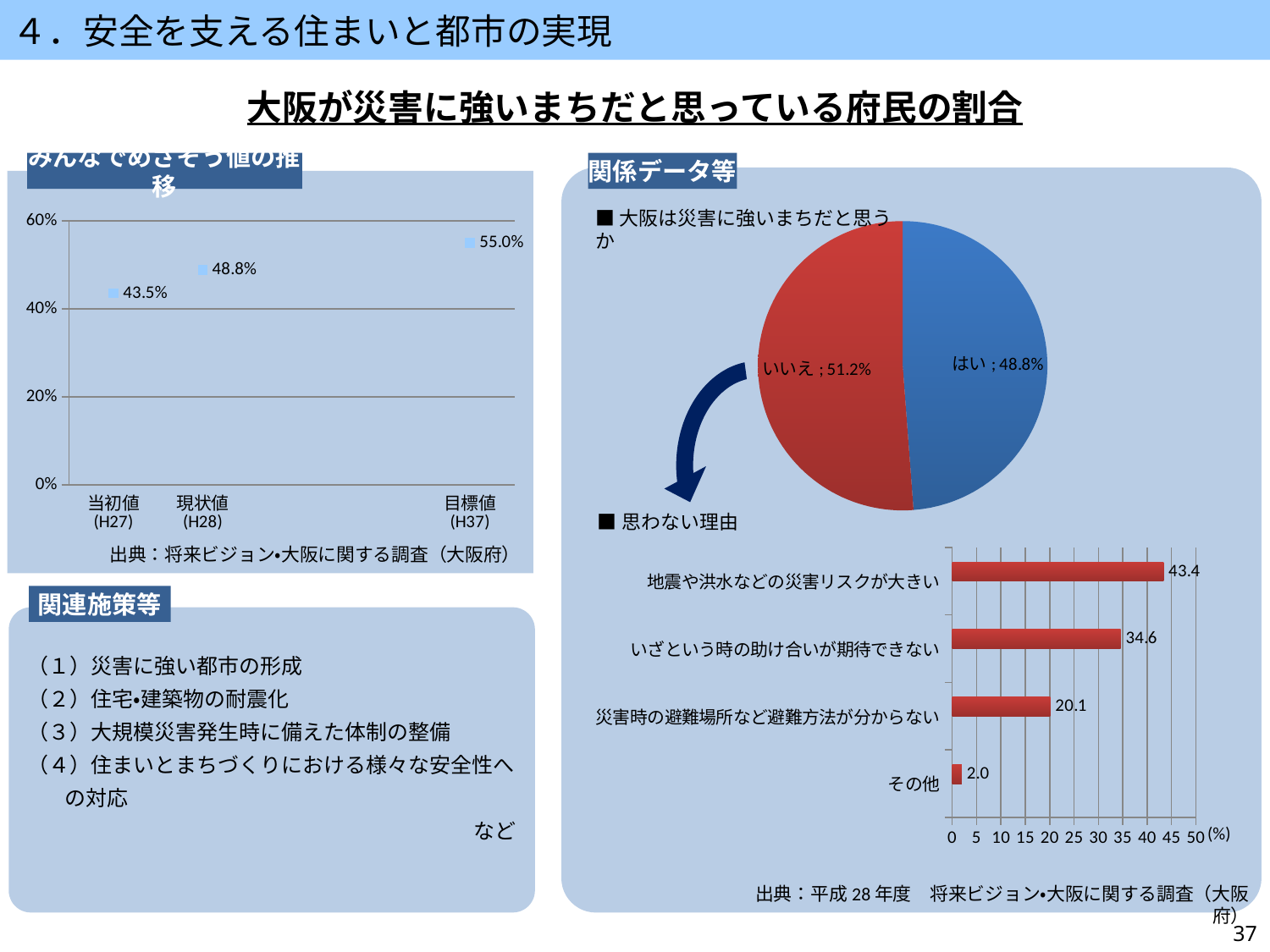
In the bar chart 「思わない理由」, which category has the lowest value? その他 In the pie chart 「大阪は災害に強いまちだと思うか」, what share is はい? 48.8% In the pie chart 「大阪は災害に強いまちだと思うか」, what colour is the いいえ slice? red In the left chart 「みんなでめざそう値の推移」, how many data points are plotted? 3 In the pie chart 「大阪は災害に強いまちだと思うか」, which slice is larger, はい or いいえ? いいえ In the bar chart 「思わない理由」, what is the difference between 地震や洪水などの災害リスクが大きい and いざという時の助け合いが期待できない? 8.8 In the left chart 「みんなでめざそう値の推移」, what is the value for 当初値 (H27)? 43.5% What kind of chart is 「思わない理由」? bar chart In the left chart 「みんなでめざそう値の推移」, what is the difference between the 目標値 (H37) and the 当初値 (H27)? 11.5% In the left chart 「みんなでめざそう値の推移」, do the values rise or fall from 当初値 (H27) to 目標値 (H37)? rise In the left chart 「みんなでめざそう値の推移」, what is the value for 目標値 (H37)? 55.0% In the bar chart 「思わない理由」, what is the value for 地震や洪水などの災害リスクが大きい? 43.4